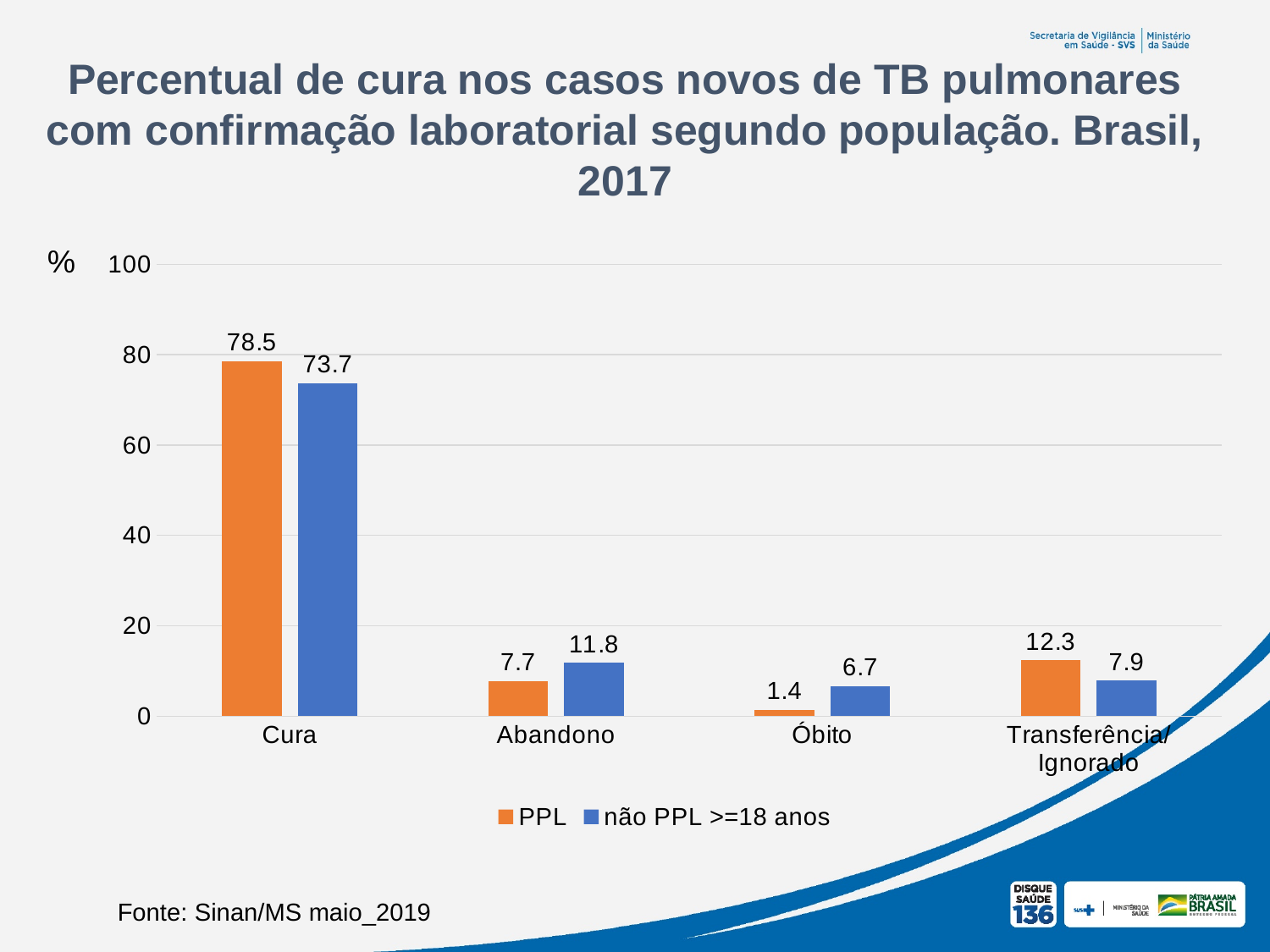
What is the value for não PPL >=18 anos in the Abandono category? 11.8 What is the value for PPL in the Óbito category? 1.4 What is the value for PPL in the Cura category? 78.5 Which category has the highest value for the PPL series? Cura What kind of chart is shown on the slide? Bar chart Which category has the lowest value for the não PPL >=18 anos series? Óbito How many categories are shown on the x axis? 4 What is the value for não PPL >=18 anos in the Transferência/Ignorado category? 7.9 How many series does the legend list? 2 In the Abandono category, which series has the larger value, PPL or não PPL >=18 anos? não PPL >=18 anos What is the source cited at the bottom of the slide? Sinan/MS maio_2019 What is the difference between the PPL and não PPL >=18 anos values in the Cura category? 4.8